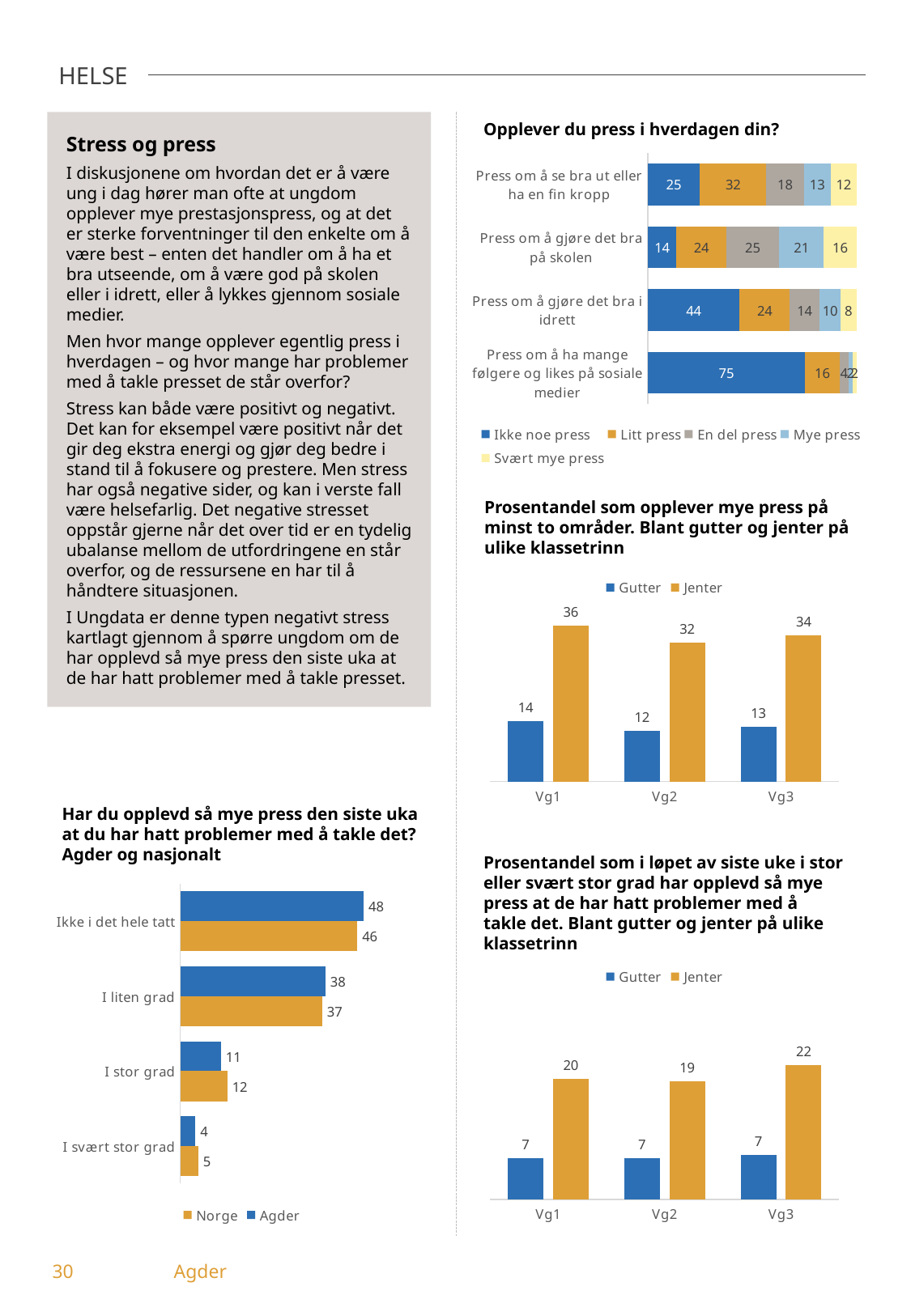
What kind of chart is 'Prosentandel som i løpet av siste uke i stor eller svært stor grad har opplevd så mye press'? Bar chart In the chart 'Prosentandel som i løpet av siste uke i stor eller svært stor grad har opplevd så mye press', what is the value for Jenter at Vg3? 22 In the chart 'Har du opplevd så mye press den siste uka at du har hatt problemer med å takle det?', what is the value for Agder for 'Ikke i det hele tatt'? 48 In the chart 'Prosentandel som opplever mye press på minst to områder', which class level has the lowest value for Gutter? Vg2 In the chart 'Opplever du press i hverdagen din?', what is the value for 'Ikke noe press' for 'Press om å gjøre det bra i idrett'? 44 In the chart 'Opplever du press i hverdagen din?', how many series does the legend list? 5 In the chart 'Prosentandel som opplever mye press på minst to områder', what is the difference between Jenter and Gutter at Vg2? 20 In the chart 'Opplever du press i hverdagen din?', what is the value for 'Litt press' for 'Press om å se bra ut eller ha en fin kropp'? 32 In the chart 'Har du opplevd så mye press den siste uka at du har hatt problemer med å takle det?', how many categories are shown? 4 In the chart 'Opplever du press i hverdagen din?', which category has the highest value for 'Ikke noe press'? Press om å ha mange følgere og likes på sosiale medier In the chart 'Har du opplevd så mye press den siste uka at du har hatt problemer med å takle det?', which is larger for 'I stor grad', Norge or Agder? Norge In the chart 'Prosentandel som opplever mye press på minst to områder', what is the value for Jenter at Vg1? 36